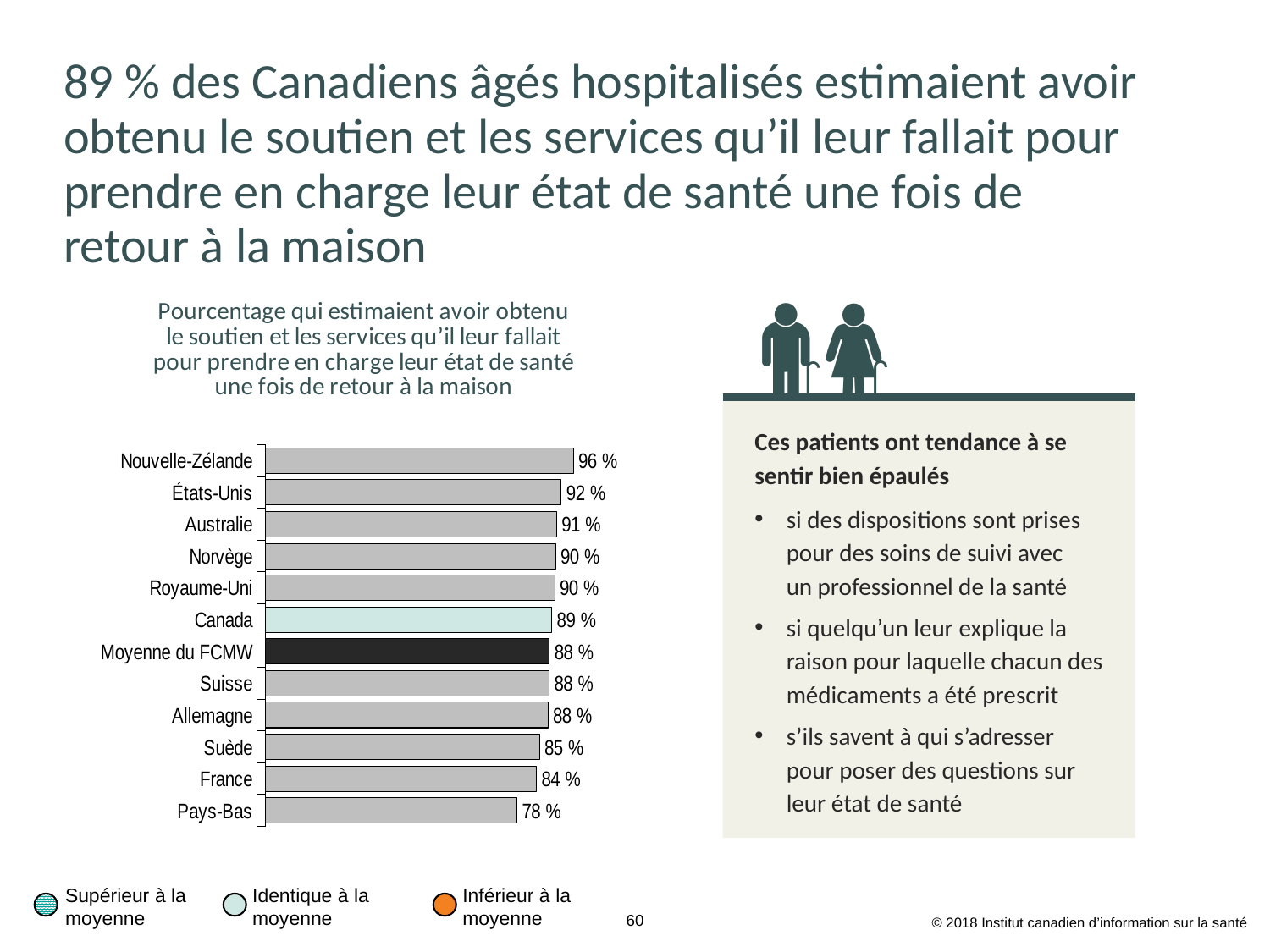
Which bar is shown in a different colour (black) from the others? Moyenne du FCMW What is the value for Nouvelle-Zélande? 96 % Which category has the lowest value? Pays-Bas What is the difference between the values for Canada and Moyenne du FCMW? 1 % Which category has the highest value? Nouvelle-Zélande What kind of chart is shown on the slide? Bar chart What is the difference between the values for Nouvelle-Zélande and Pays-Bas? 18 % Which is larger, the value for États-Unis or the value for France? États-Unis What is the value for Suède? 85 % What is the value for Moyenne du FCMW? 88 % What is the value for Canada? 89 % How many categories are shown in the chart? 12